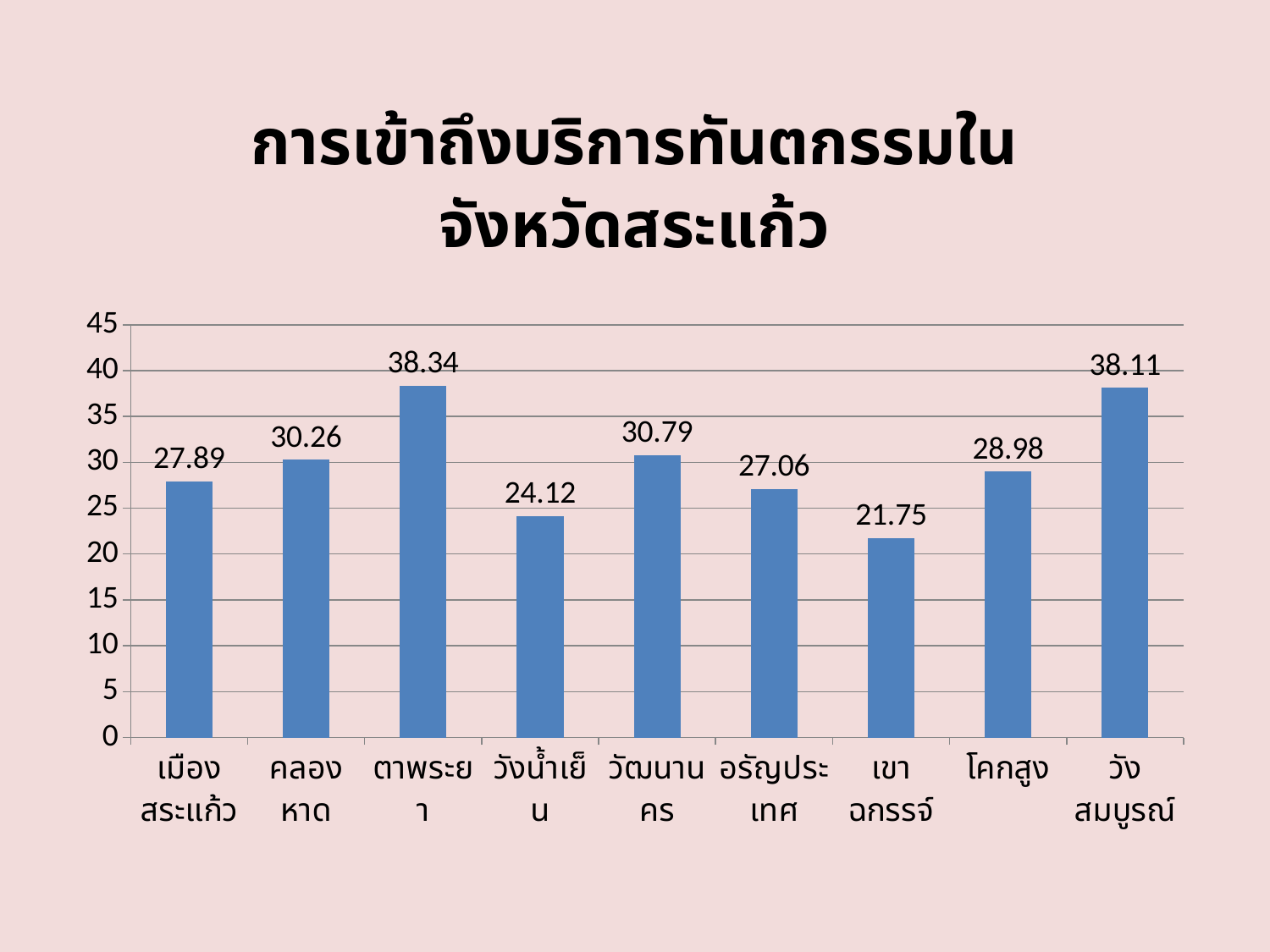
What is the difference between the values for ตาพระยา and เขาฉกรรจ์? 16.59 What is the value for ตาพระยา? 38.34 What type of chart is shown on the slide? bar chart Is the value for วังสมบูรณ์ greater or less than 35? greater What is the value for เขาฉกรรจ์? 21.75 How many districts (categories) are shown in the chart? 9 Which is larger, the value for วัฒนานคร or the value for อรัญประเทศ? วัฒนานคร Which district has the highest value? ตาพระยา Which district has the lowest value? เขาฉกรรจ์ What is the value for โคกสูง? 28.98 What is the title of the chart? การเข้าถึงบริการทันตกรรมในจังหวัดสระแก้ว What is the value for วังน้ำเย็น? 24.12